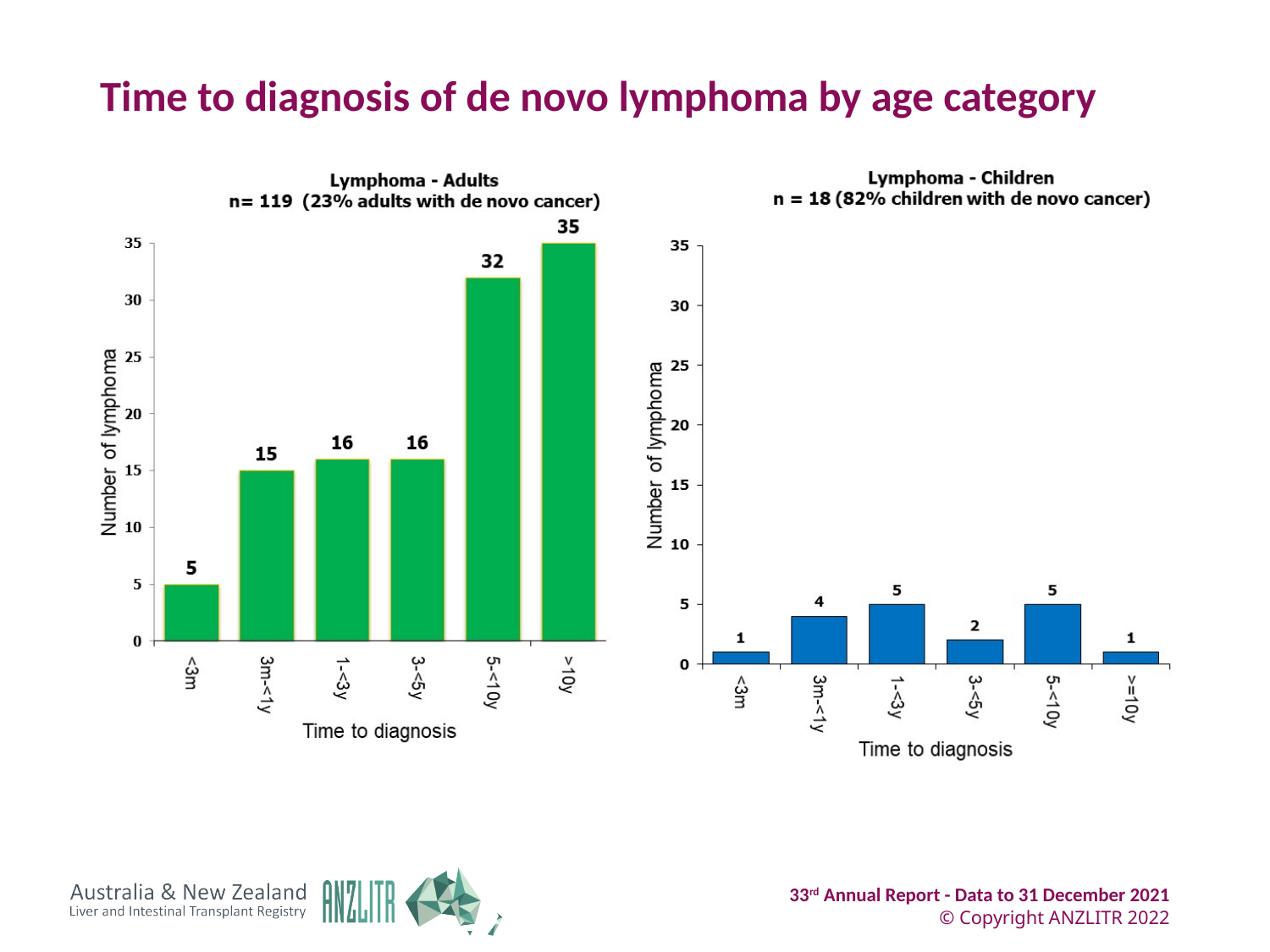
What is the sample size n stated in the title of the Lymphoma - Children chart? 18 In the Lymphoma - Children chart, what is the difference between the number of lymphoma for 1-<3y and for 3-<5y? 3 What kind of chart is the Lymphoma - Children chart? bar chart In the Lymphoma - Children chart, is the value for 1-<3y greater or less than 10? less In the Lymphoma - Adults chart, which is larger: the number of lymphoma for 3m-<1y or for 5-<10y? 5-<10y In the Lymphoma - Adults chart, what is the number of lymphoma for the 5-<10y time to diagnosis? 32 In the Lymphoma - Children chart, what is the number of lymphoma for the 3m-<1y time to diagnosis? 4 In the Lymphoma - Adults chart, what is the difference between the number of lymphoma for >10y and for <3m? 30 In the Lymphoma - Adults chart, which time to diagnosis category has the highest number of lymphoma? >10y How many time to diagnosis categories are shown in the Lymphoma - Adults chart? 6 In the Lymphoma - Adults chart, which time to diagnosis category has the lowest number of lymphoma? <3m In the Lymphoma - Children chart, which time to diagnosis category has the lowest number of lymphoma? <3m and >=10y